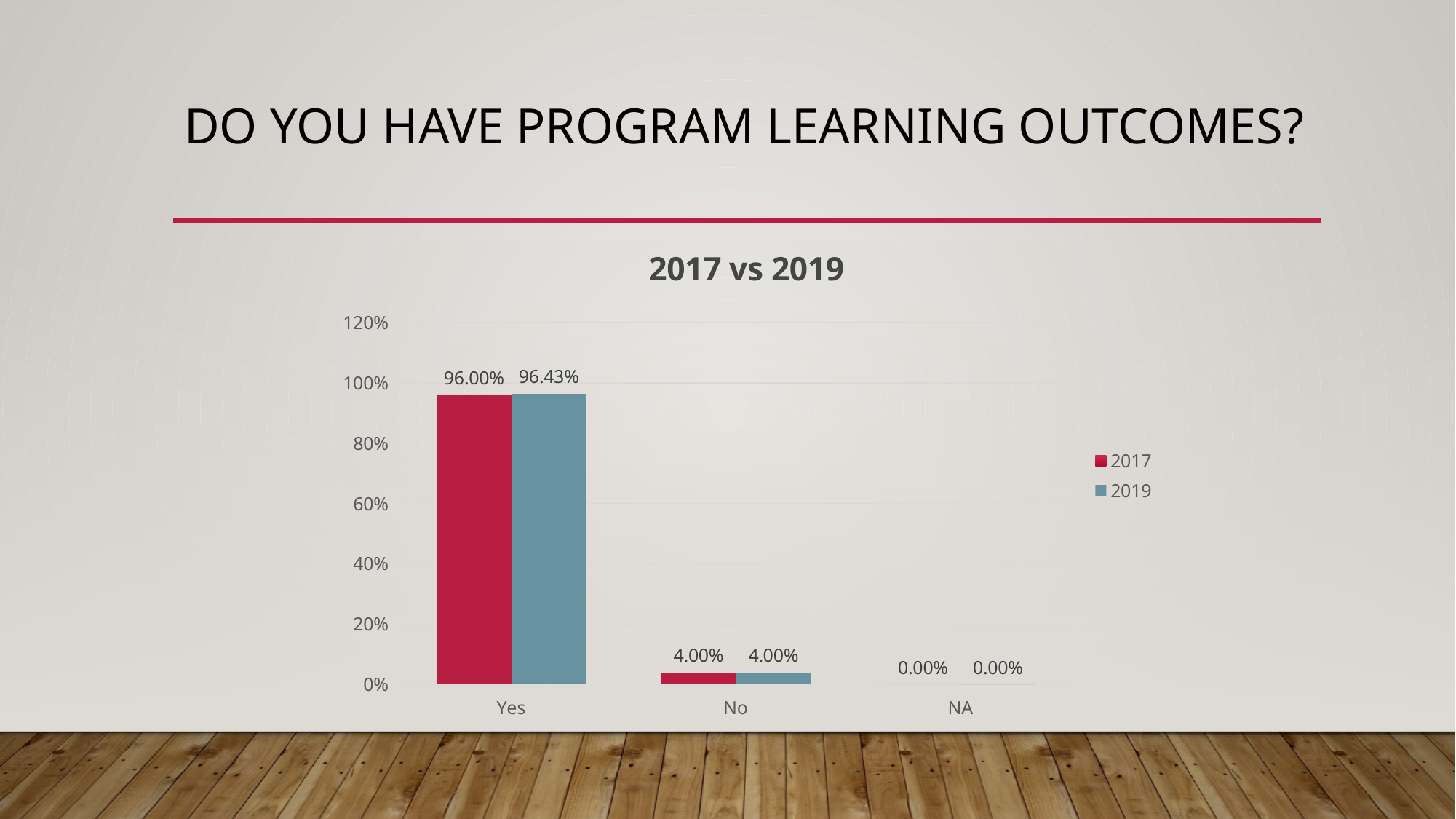
What is the value for Yes in the 2017 series? 96.00% Which category has the highest value in the 2019 series? Yes What kind of chart is shown on the slide? Bar chart Which category has the lowest value in the 2017 series? NA What is the value for NA in the 2019 series? 0.00% What is the value for Yes in the 2019 series? 96.43% What is the value for No in the 2017 series? 4.00% What is the difference between the Yes and No values in the 2017 series? 92.00% How many categories are shown on the x axis? 3 What is the title of the chart? 2017 vs 2019 Is the value for Yes in 2017 greater or less than 80%? greater How many series does the legend list? 2